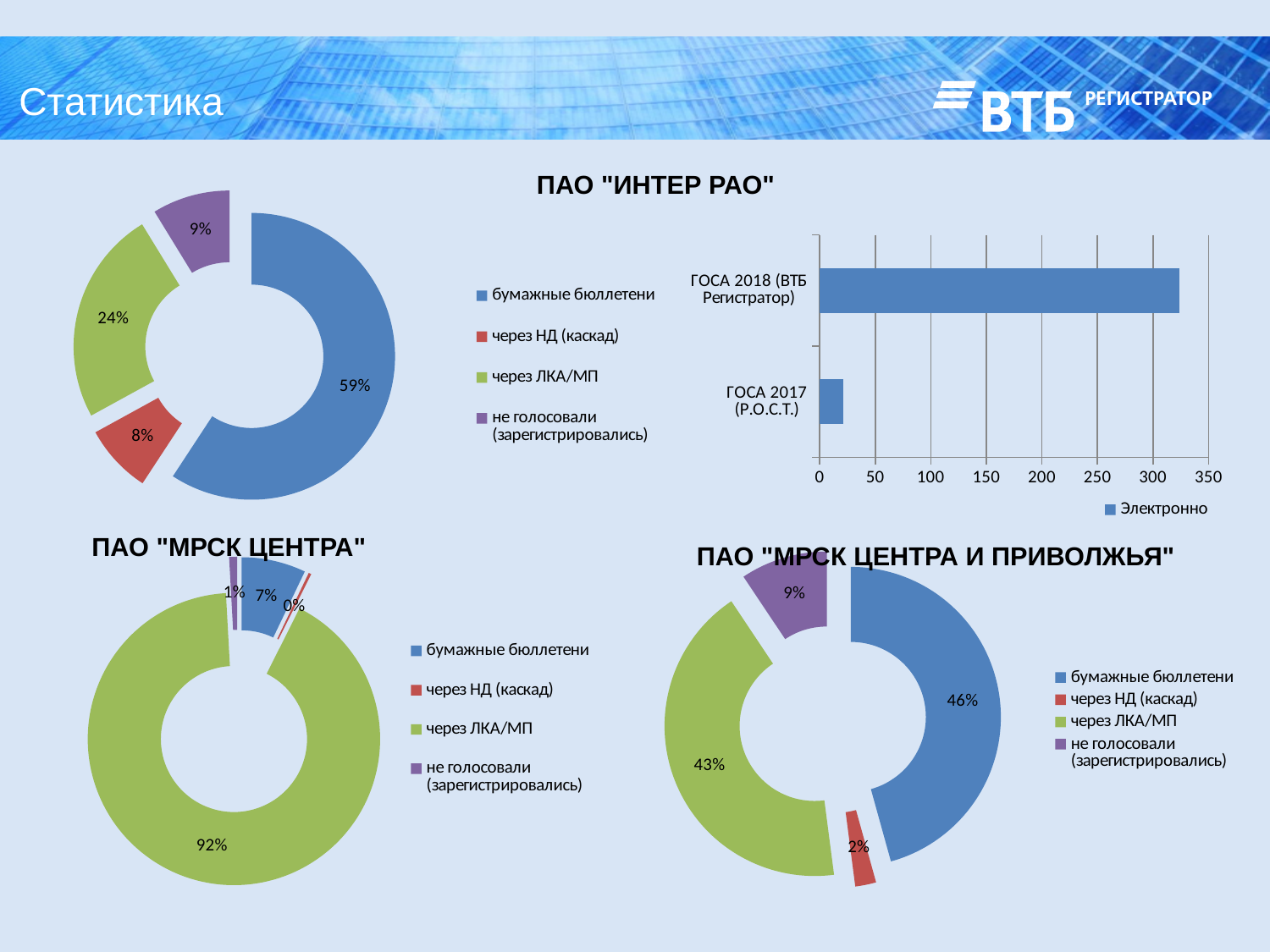
In the chart titled ПАО "МРСК ЦЕНТРА И ПРИВОЛЖЬЯ", what share is shown for "не голосовали (зарегистрировались)"? 9% In the bar chart under the heading ПАО "ИНТЕР РАО", is the value for ГОСА 2018 (ВТБ Регистратор) greater or less than 300? greater How many entries does the legend of the chart titled ПАО "МРСК ЦЕНТРА И ПРИВОЛЖЬЯ" list? 4 In the bar chart under the heading ПАО "ИНТЕР РАО", which category has the higher value? ГОСА 2018 (ВТБ Регистратор) In the doughnut chart in the top-left of the slide, what share is shown for "бумажные бюллетени"? 59% In the doughnut chart in the top-left of the slide, what share is shown for "через ЛКА/МП"? 24% In the chart titled ПАО "МРСК ЦЕНТРА", what share is shown for "через ЛКА/МП"? 92% What kind of chart is shown under the heading ПАО "ИНТЕР РАО" on the right side of the slide? bar chart In the doughnut chart in the top-left of the slide, which category has the smallest share? через НД (каскад) In the bar chart under the heading ПАО "ИНТЕР РАО", is the value for ГОСА 2017 (Р.О.С.Т.) greater or less than 50? less In the chart titled ПАО "МРСК ЦЕНТРА", what share is shown for "бумажные бюллетени"? 7% In the chart titled ПАО "МРСК ЦЕНТРА И ПРИВОЛЖЬЯ", what is the difference between the shares for "бумажные бюллетени" and "через ЛКА/МП"? 3%